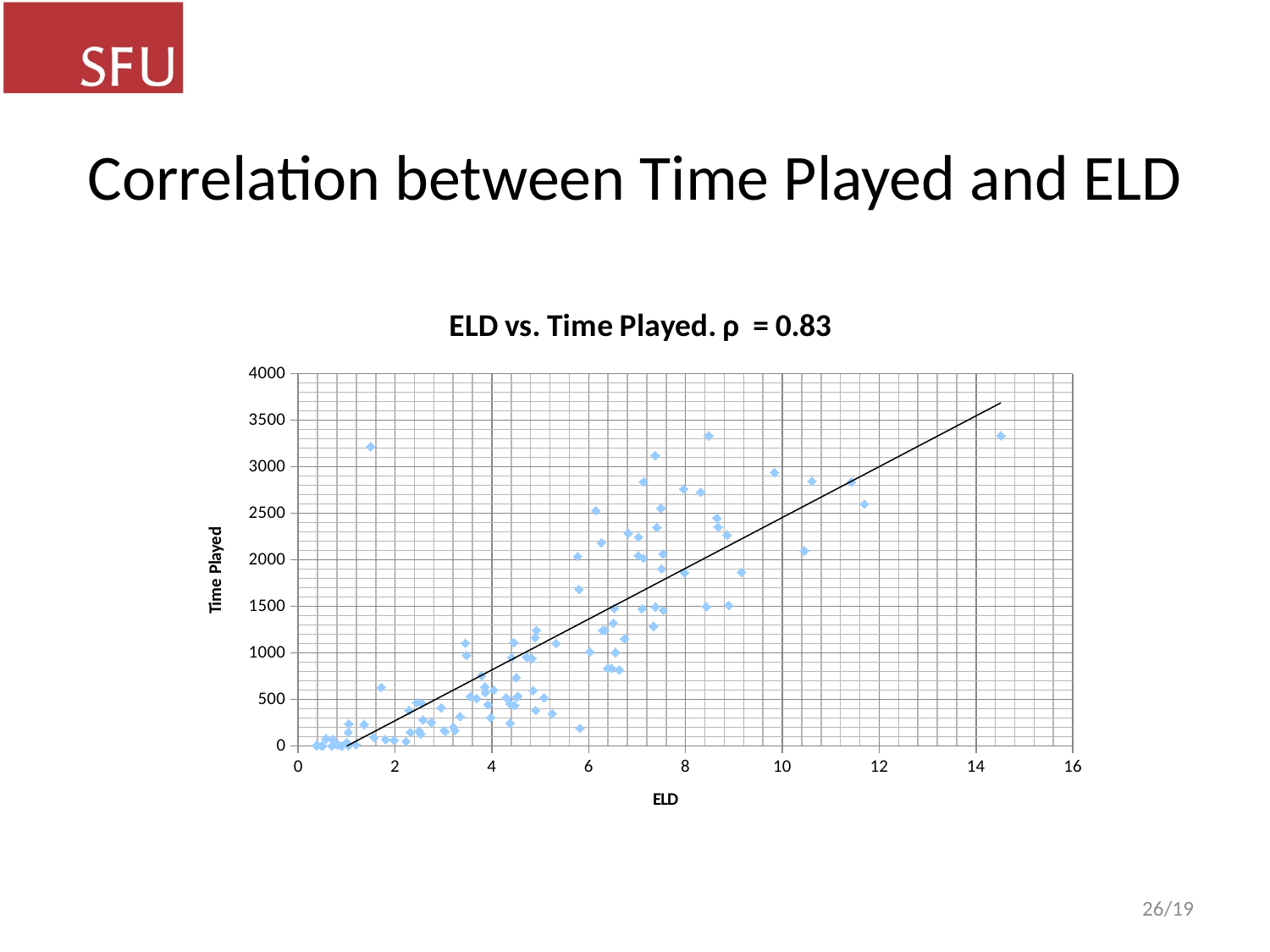
What is the title of the chart? ELD vs. Time Played. ρ = 0.83 What variable is plotted on the x axis? ELD Are most of the points with ELD below 2 above or below a Time Played of 500? below Is the Time Played value for the point near ELD 1.5 that lies far above the trend line greater or less than 3000? greater What correlation coefficient (ρ) is reported in the chart title? 0.83 What kind of chart is shown on the slide? Scatter plot Does Time Played generally rise or fall as ELD increases along the x axis? Rise Is the Time Played value for the point near ELD 11.7 greater or less than 3000? less Is the slope of the fitted trend line positive or negative? Positive What is the highest tick value shown on the x axis (ELD)? 16 What is the highest tick value shown on the y axis (Time Played)? 4000